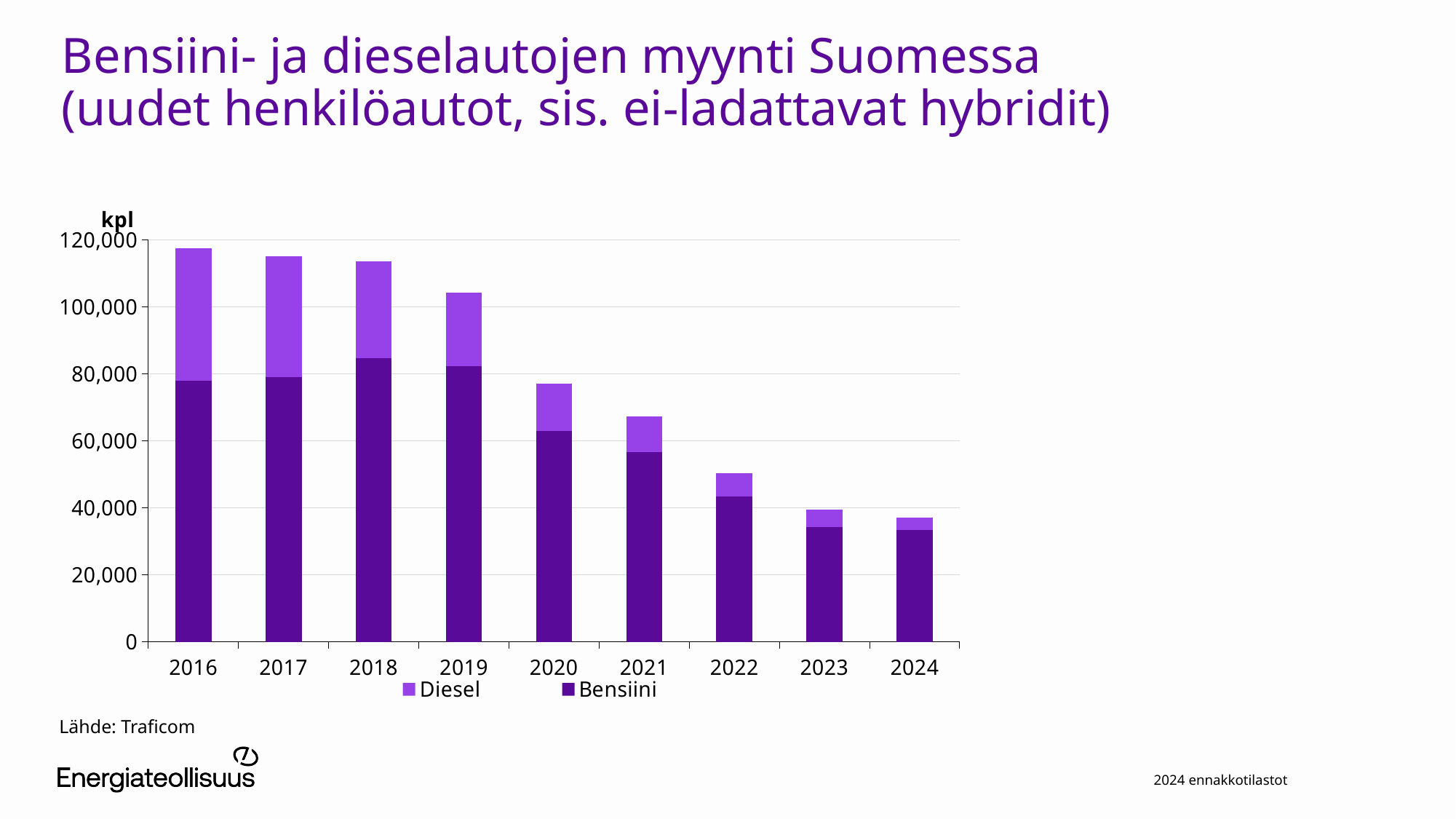
Is the total bar for 2024 greater or less than 40,000? less What kind of chart is shown on the slide? stacked bar chart Which year has the lowest total bar? 2024 Which two series are listed in the chart legend? Diesel and Bensiini How many years are shown on the x axis of the chart? 9 Which year has a larger total bar, 2019 or 2020? 2019 Is the Bensiini value for 2021 greater or less than 60,000? less Is the total bar for 2016 greater or less than 100,000? greater Do the total bar heights rise or fall from 2016 to 2024? fall How many series does the legend list? 2 Which year has the highest total bar? 2016 What unit is shown at the top of the vertical axis? kpl